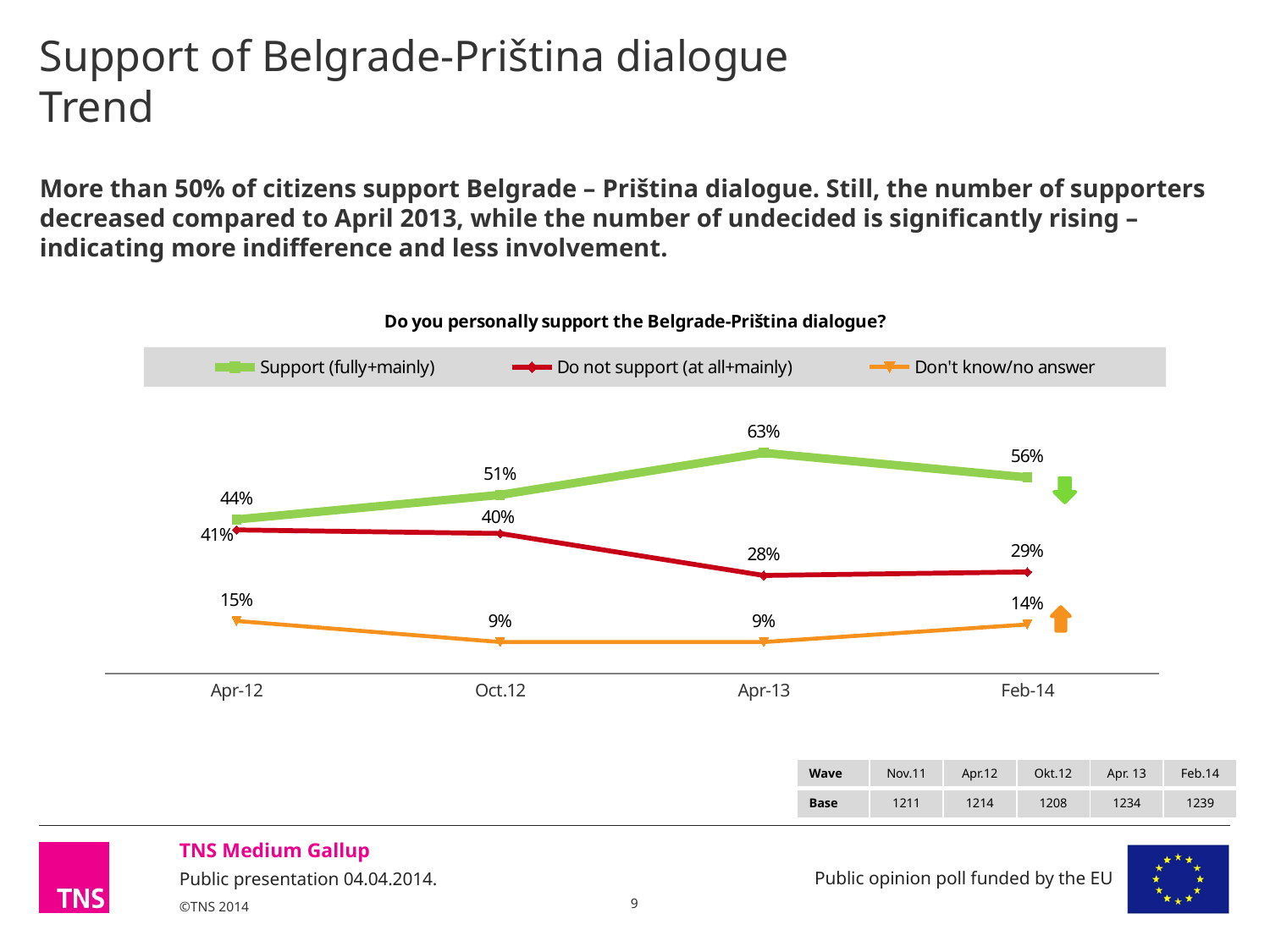
What is the value for Don't know/no answer in Feb-14? 14% In which period is the Support (fully+mainly) value highest? Apr-13 What is the value for Support (fully+mainly) in Apr-13? 63% In which period is the Do not support (at all+mainly) value lowest? Apr-13 How many time periods are shown on the x axis? 4 What is the difference between the Support (fully+mainly) values in Apr-13 and Feb-14? 7% Does the Do not support (at all+mainly) series rise or fall from Apr-12 to Apr-13? fall What is the title of the chart? Do you personally support the Belgrade-Priština dialogue? What kind of chart is shown on the slide? line chart Which is larger in Apr-12: Support (fully+mainly) or Do not support (at all+mainly)? Support (fully+mainly) What is the value for Do not support (at all+mainly) in Oct.12? 40% How many series does the legend list? 3